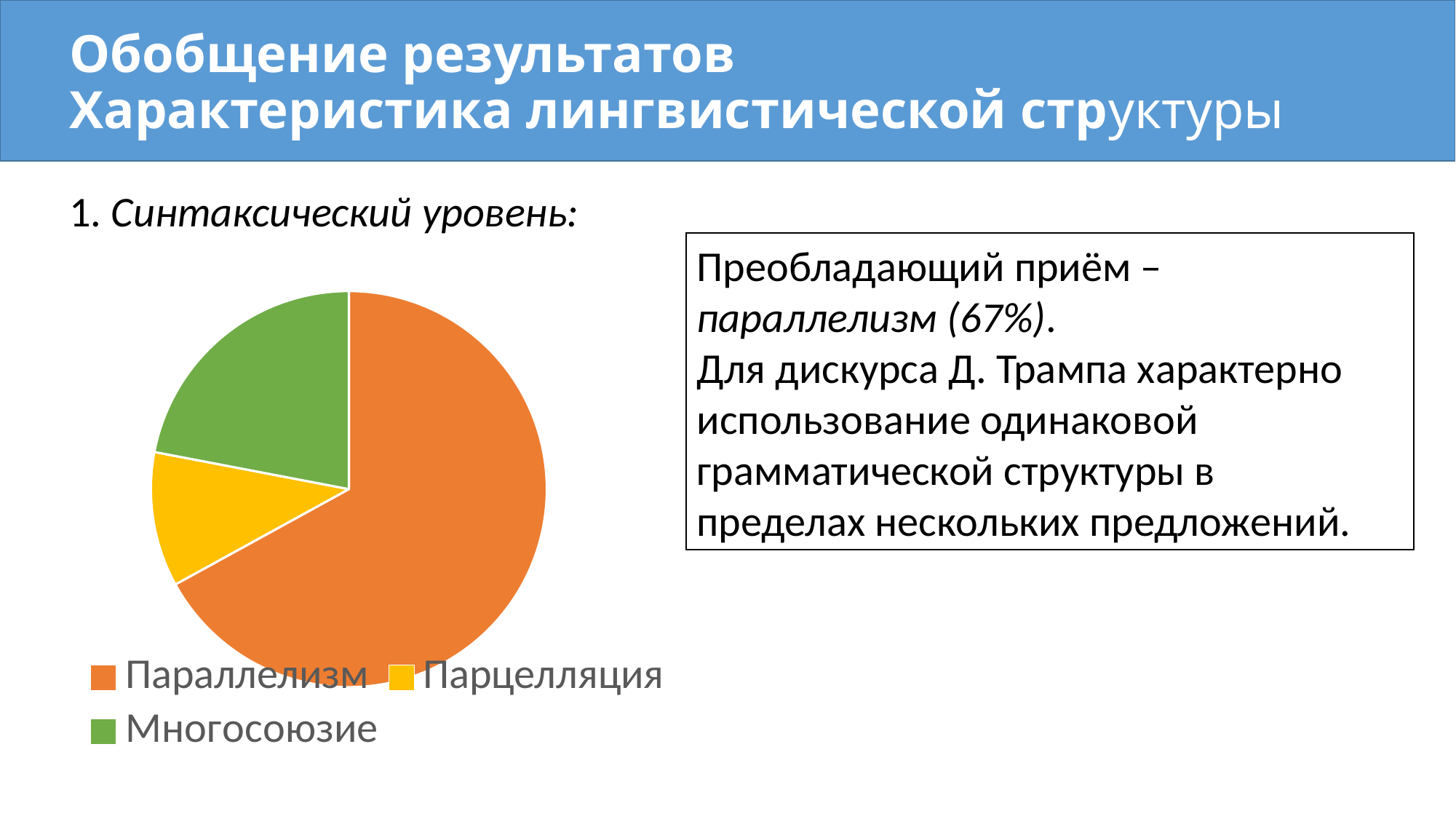
Which category has the largest slice in the pie chart? Параллелизм How many slices does the pie chart have? 3 Which slice is larger in the pie chart, Многосоюзие or Парцелляция? Многосоюзие Which category is shown in green in the pie chart? Многосоюзие What kind of chart is shown on the slide? pie chart How many entries does the legend of the pie chart list? 3 Which slice is larger in the pie chart, Параллелизм or Многосоюзие? Параллелизм What share of the pie does Параллелизм account for, according to the slide? 67% What colour is the Параллелизм slice in the pie chart? orange Which category has the smallest slice in the pie chart? Парцелляция